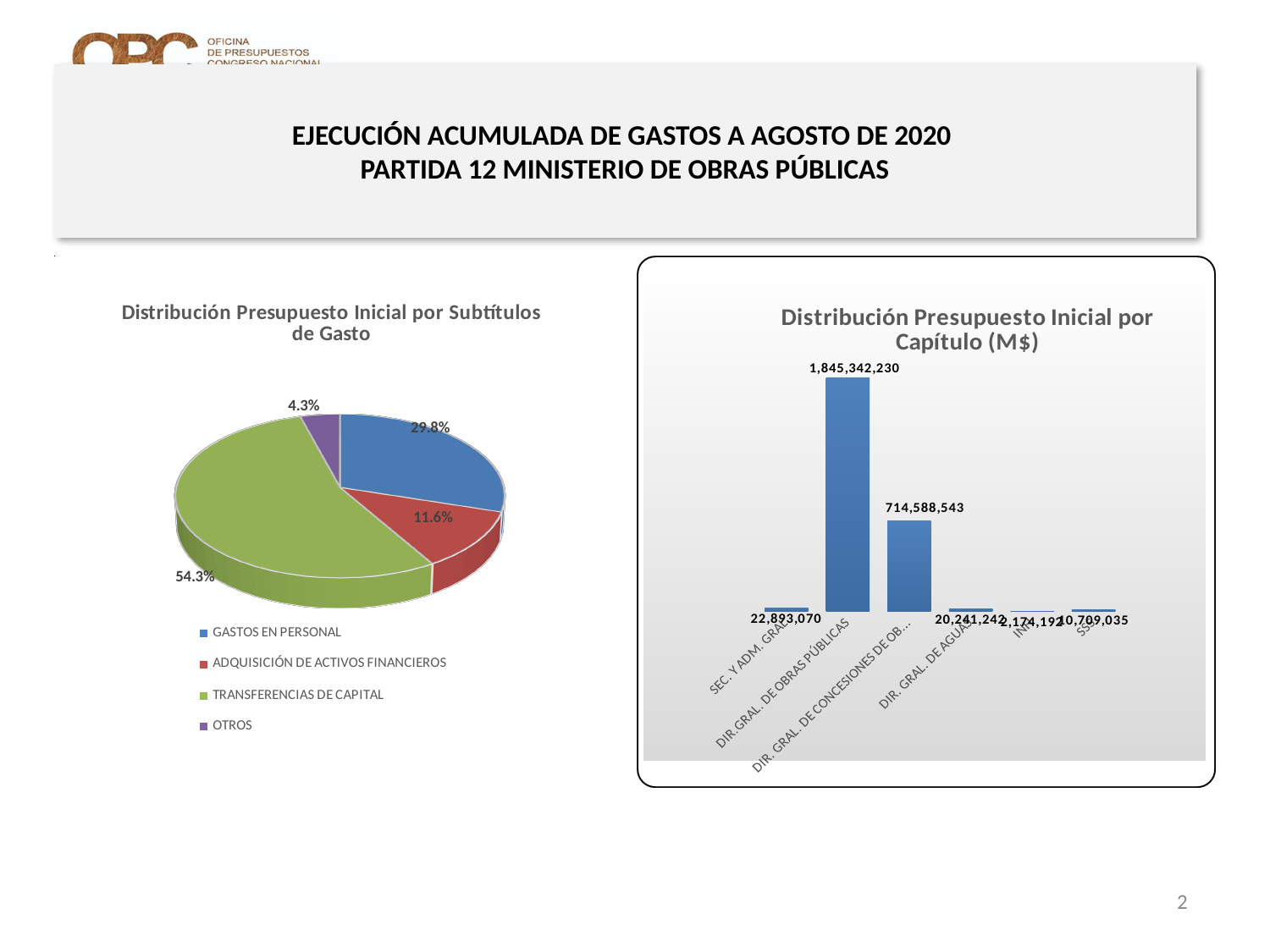
In the pie chart 'Distribución Presupuesto Inicial por Subtítulos de Gasto', how many categories are shown? 4 What kind of chart is the one on the left of the slide? Pie chart In the pie chart 'Distribución Presupuesto Inicial por Subtítulos de Gasto', what share does GASTOS EN PERSONAL have? 29.8% In the pie chart 'Distribución Presupuesto Inicial por Subtítulos de Gasto', what share does TRANSFERENCIAS DE CAPITAL have? 54.3% In the chart 'Distribución Presupuesto Inicial por Capítulo (M$)', what is the value for SEC. Y ADM. GRAL.? 22,893,070 In the chart 'Distribución Presupuesto Inicial por Capítulo (M$)', which is larger: SEC. Y ADM. GRAL. or DIR. GRAL. DE AGUAS? SEC. Y ADM. GRAL. In the pie chart 'Distribución Presupuesto Inicial por Subtítulos de Gasto', which category has the largest slice? TRANSFERENCIAS DE CAPITAL In the chart 'Distribución Presupuesto Inicial por Capítulo (M$)', which capítulo has the highest value? DIR.GRAL. DE OBRAS PÚBLICAS In the pie chart 'Distribución Presupuesto Inicial por Subtítulos de Gasto', how many percentage points larger is TRANSFERENCIAS DE CAPITAL than GASTOS EN PERSONAL? 24.5% In the pie chart 'Distribución Presupuesto Inicial por Subtítulos de Gasto', which category has the smallest slice? OTROS In the chart 'Distribución Presupuesto Inicial por Capítulo (M$)', what is the difference between DIR.GRAL. DE OBRAS PÚBLICAS and DIR. GRAL. DE CONCESIONES DE OB...? 1,130,753,687 In the chart 'Distribución Presupuesto Inicial por Capítulo (M$)', what is the value for DIR.GRAL. DE OBRAS PÚBLICAS? 1,845,342,230